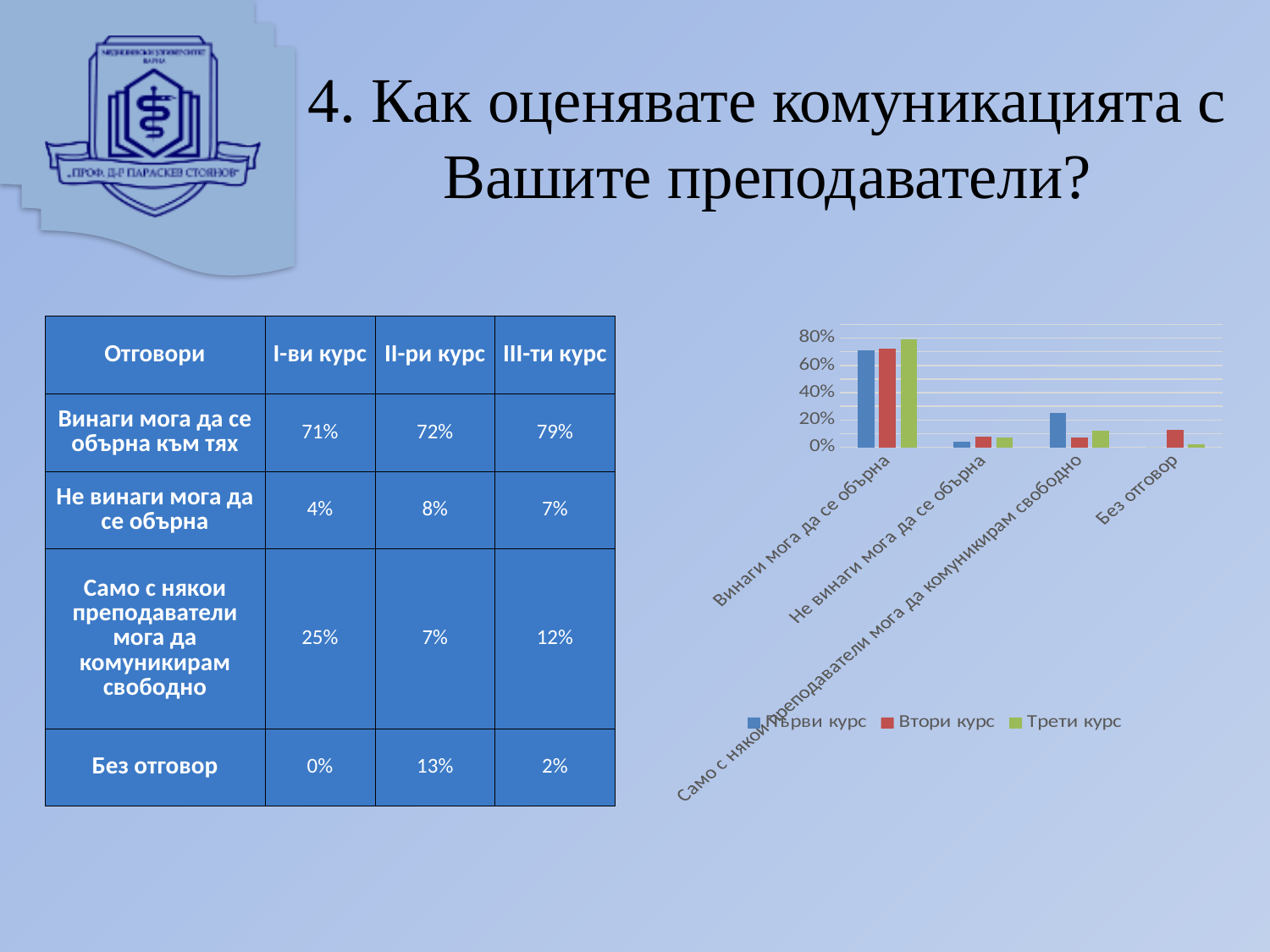
Is the value for Трети курс in the category "Винаги мога да се обърна" greater or less than 60%? greater What is the value for Първи курс in the category "Само с някои преподаватели мога да комуникирам свободно"? 25% What is the difference between Първи курс and Втори курс in the category "Само с някои преподаватели мога да комуникирам свободно"? 18% Which category has the lowest value for Първи курс? Без отговор Which series is shown in green in the chart legend? Трети курс What is the value for Трети курс in the category "Винаги мога да се обърна"? 79% What kind of chart is shown on the slide? bar chart In the category "Без отговор", which is larger: Втори курс or Трети курс? Втори курс How many categories are shown on the x axis of the chart? 4 What is the value for Втори курс in the category "Без отговор"? 13% Which category has the highest value for Първи курс? Винаги мога да се обърна How many series does the chart legend list? 3